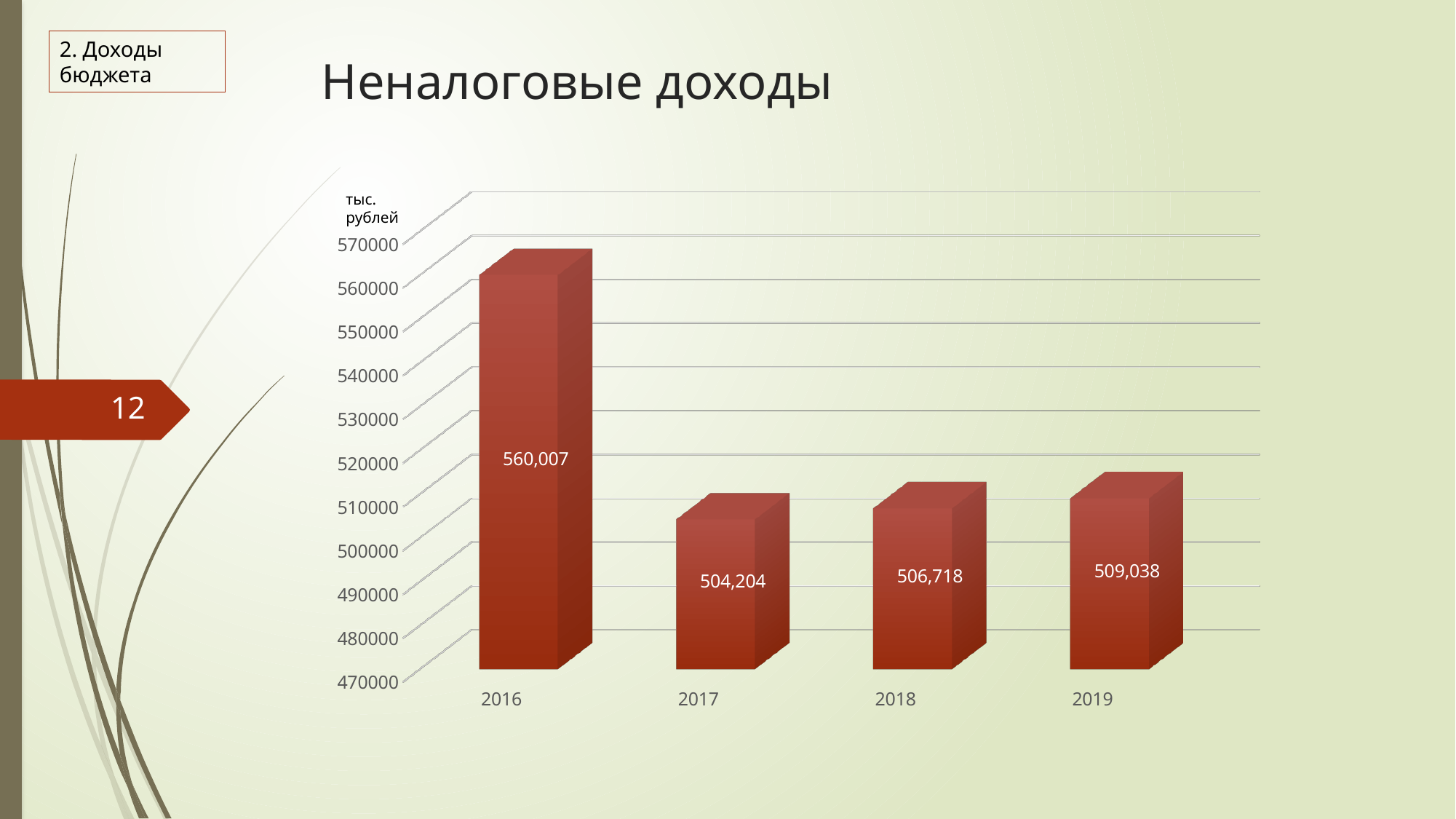
What is the difference between the values for 2016 and 2017? 55,803 What is the value for 2019? 509,038 Which year has the lowest value? 2017 What is the title of the chart? Неналоговые доходы What is the difference between the values for 2019 and 2018? 2,320 Which year has the highest value? 2016 What is the value for 2018? 506,718 What is the value for 2016? 560,007 What is the value for 2017? 504,204 Which is larger, the value for 2018 or the value for 2019? 2019 How many years are shown on the x axis? 4 Is the value for 2016 greater or less than 550000? greater